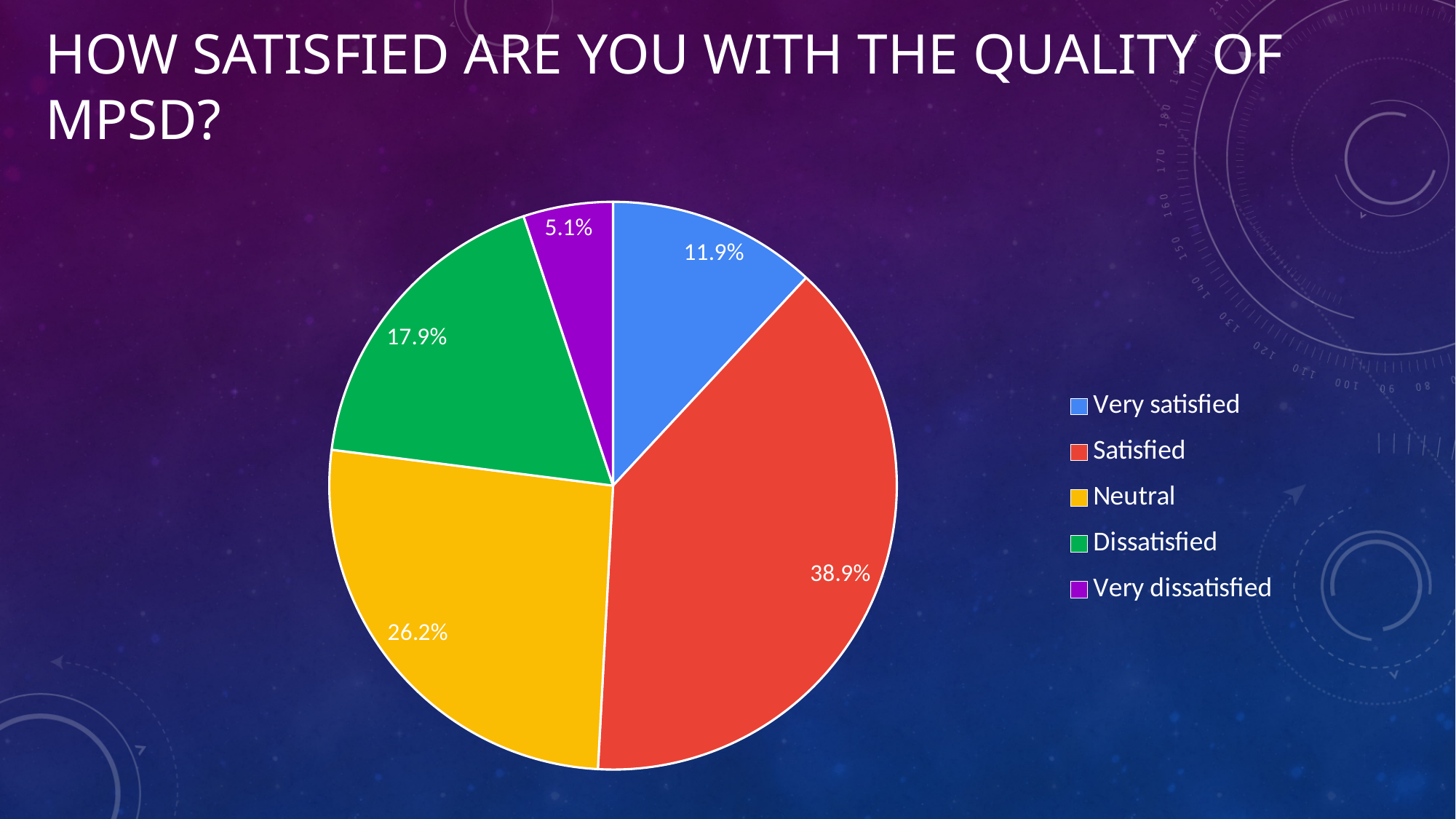
What percentage of respondents are Very dissatisfied? 5.1% Which category has the smallest share of the pie? Very dissatisfied What is the difference in percentage points between Satisfied and Neutral? 12.7 What colour is the Neutral slice? Yellow Which is larger, the share for Dissatisfied or the share for Very satisfied? Dissatisfied What is the combined share of Dissatisfied and Very dissatisfied? 23.0% How many categories does the pie chart have? 5 What percentage of respondents are Very satisfied? 11.9% What kind of chart is shown on the slide? Pie chart Which category has the largest share of the pie? Satisfied What percentage of respondents are Neutral? 26.2% What percentage of respondents are Satisfied? 38.9%